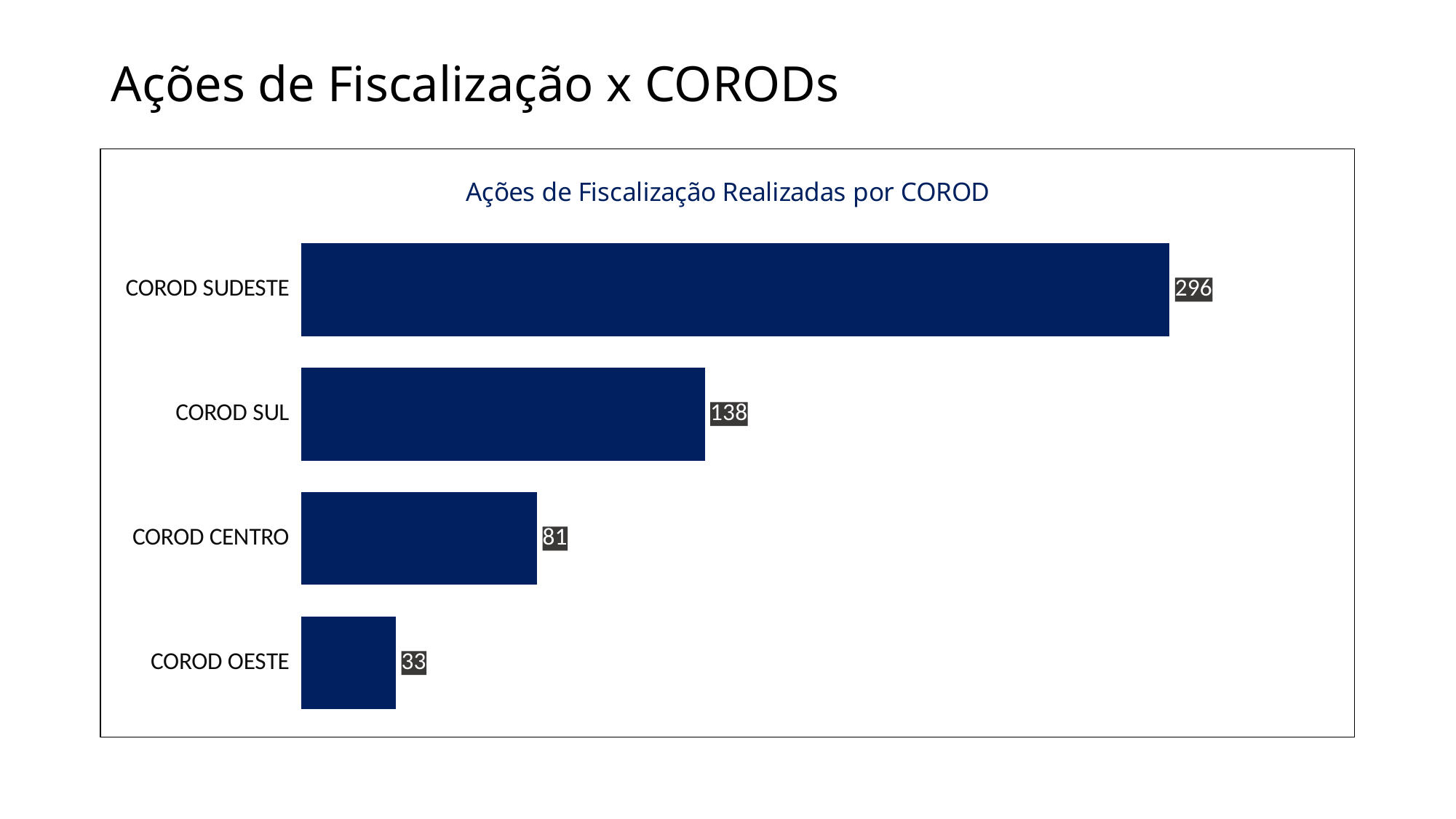
What is the value for COROD SUL? 138 Which is larger, the value for COROD SUL or the value for COROD CENTRO? COROD SUL What is the difference between the values for COROD CENTRO and COROD OESTE? 48 What is the title of the chart? Ações de Fiscalização Realizadas por COROD Which COROD has the lowest number of actions? COROD OESTE How many CORODs are shown in the chart? 4 What is the value for COROD CENTRO? 81 Which COROD has the highest number of actions? COROD SUDESTE What is the value for COROD SUDESTE? 296 What is the difference between the values for COROD SUDESTE and COROD SUL? 158 What is the value for COROD OESTE? 33 What kind of chart is shown on the slide? Bar chart